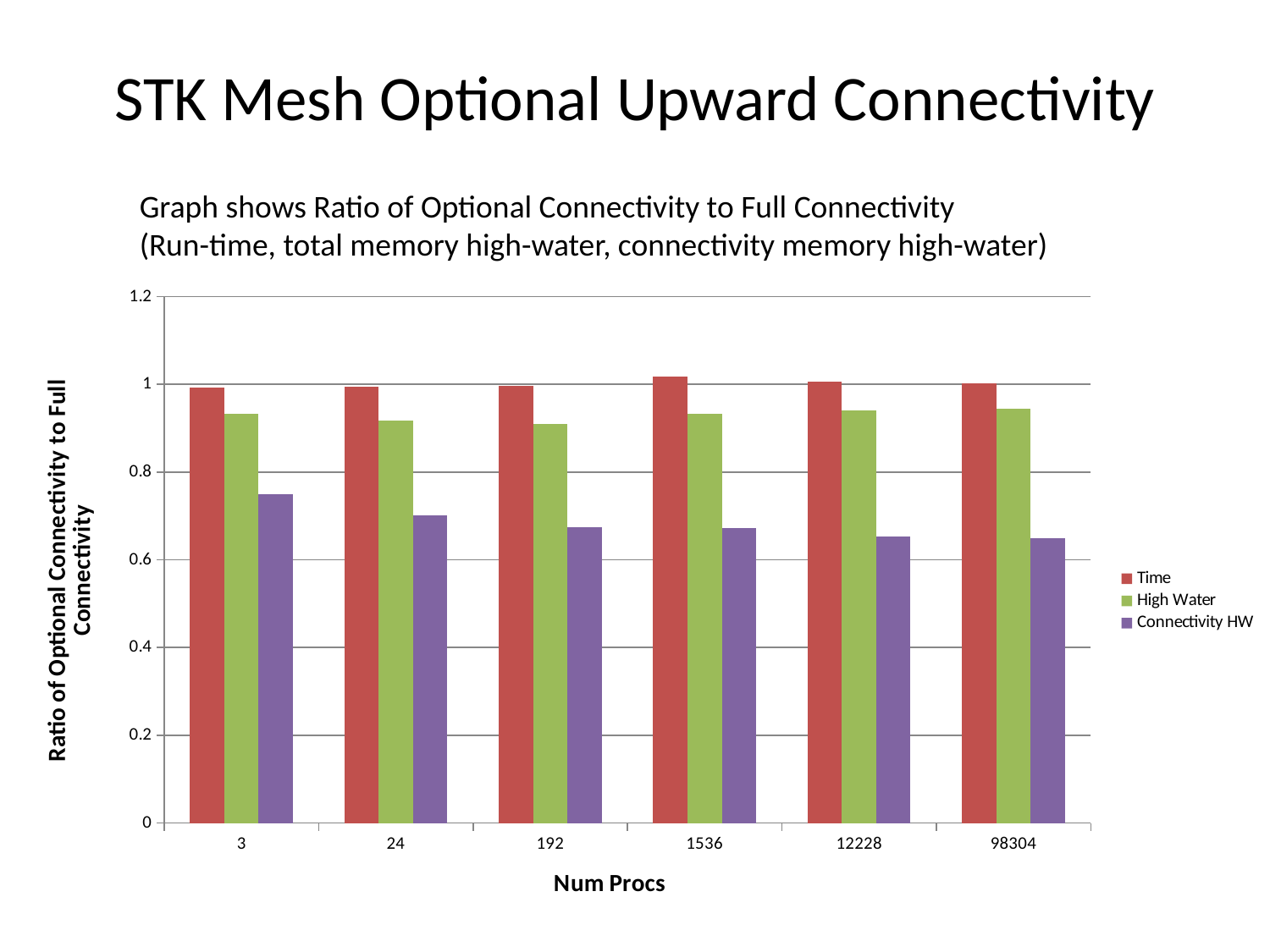
Is the value for Connectivity HW at 98304 procs greater or less than 0.6? greater How many series does the legend list? 3 Is the value for Connectivity HW at 3 procs greater or less than 0.8? less Which series is plotted in purple? Connectivity HW Which series has the lowest value in every Num Procs group? Connectivity HW What kind of chart is shown on the slide? bar chart Is the value for High Water at 24 procs greater or less than 0.8? greater How many Num Procs categories are shown on the x axis? 6 Do the Connectivity HW values rise or fall as Num Procs increases along the x axis? fall At 192 procs, which is larger: High Water or Connectivity HW? High Water What is the title of the x axis? Num Procs For Connectivity HW, which is larger: the value at 3 procs or at 24 procs? 3 procs